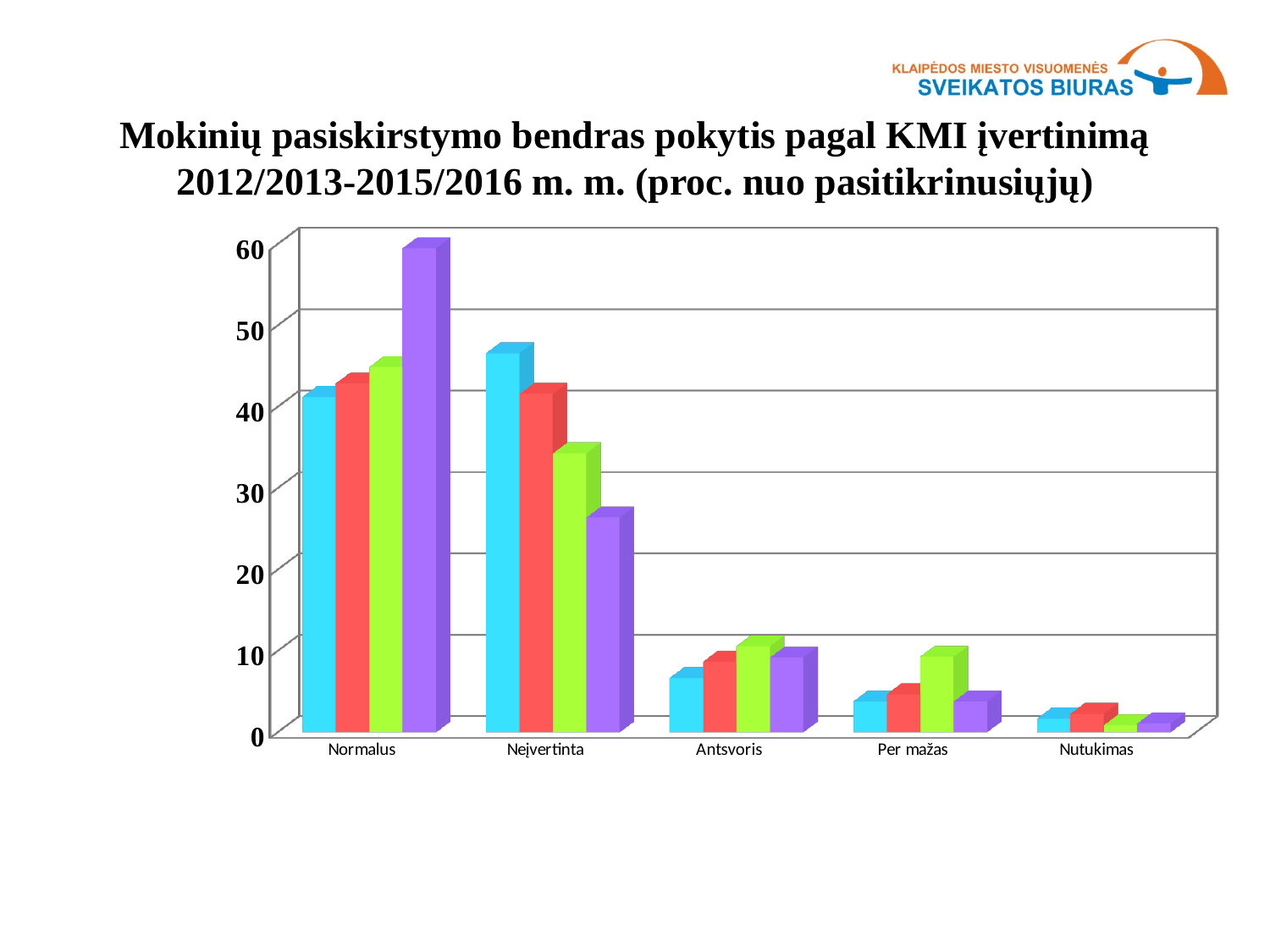
Is the value of the purple bar for Normalus greater or less than 50? greater Which is larger, the cyan bar for Normalus or the cyan bar for Neįvertinta? Neįvertinta How many bars are shown for each category in the chart? 4 What kind of chart is shown on the slide? bar chart Is the value of the purple bar for Neįvertinta greater or less than 30? less Which is larger, the purple bar for Normalus or the purple bar for Neįvertinta? Normalus How many categories are shown on the x axis of the chart? 5 Which is larger, the green bar for Per mažas or the purple bar for Per mažas? green bar Which category has the tallest purple bar? Normalus Is the value of the cyan bar for Neįvertinta greater or less than 40? greater Which category has the lowest cyan bar? Nutukimas